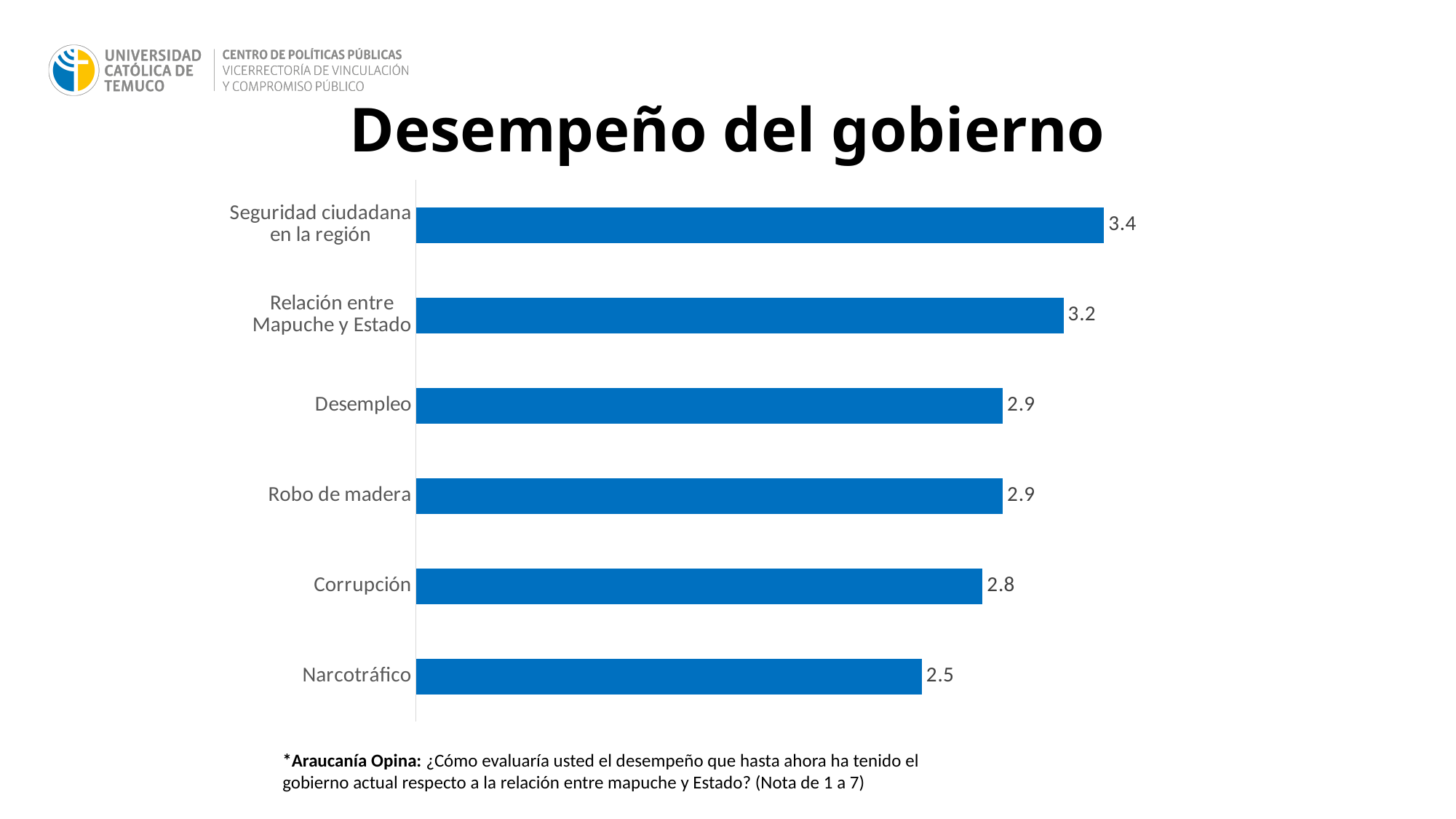
How many categories are shown in the chart? 6 What is the difference between the values for Relación entre Mapuche y Estado and Corrupción? 0.4 What is the difference between the values for Seguridad ciudadana en la región and Narcotráfico? 0.9 Which category has the lowest value? Narcotráfico What is the value for Relación entre Mapuche y Estado? 3.2 What is the value for Seguridad ciudadana en la región? 3.4 Which is larger, the value for Desempleo or the value for Narcotráfico? Desempleo What is the value for Corrupción? 2.8 Which category has the highest value? Seguridad ciudadana en la región What is the title of the slide? Desempeño del gobierno What kind of chart is shown on the slide? Bar chart What is the value for Narcotráfico? 2.5